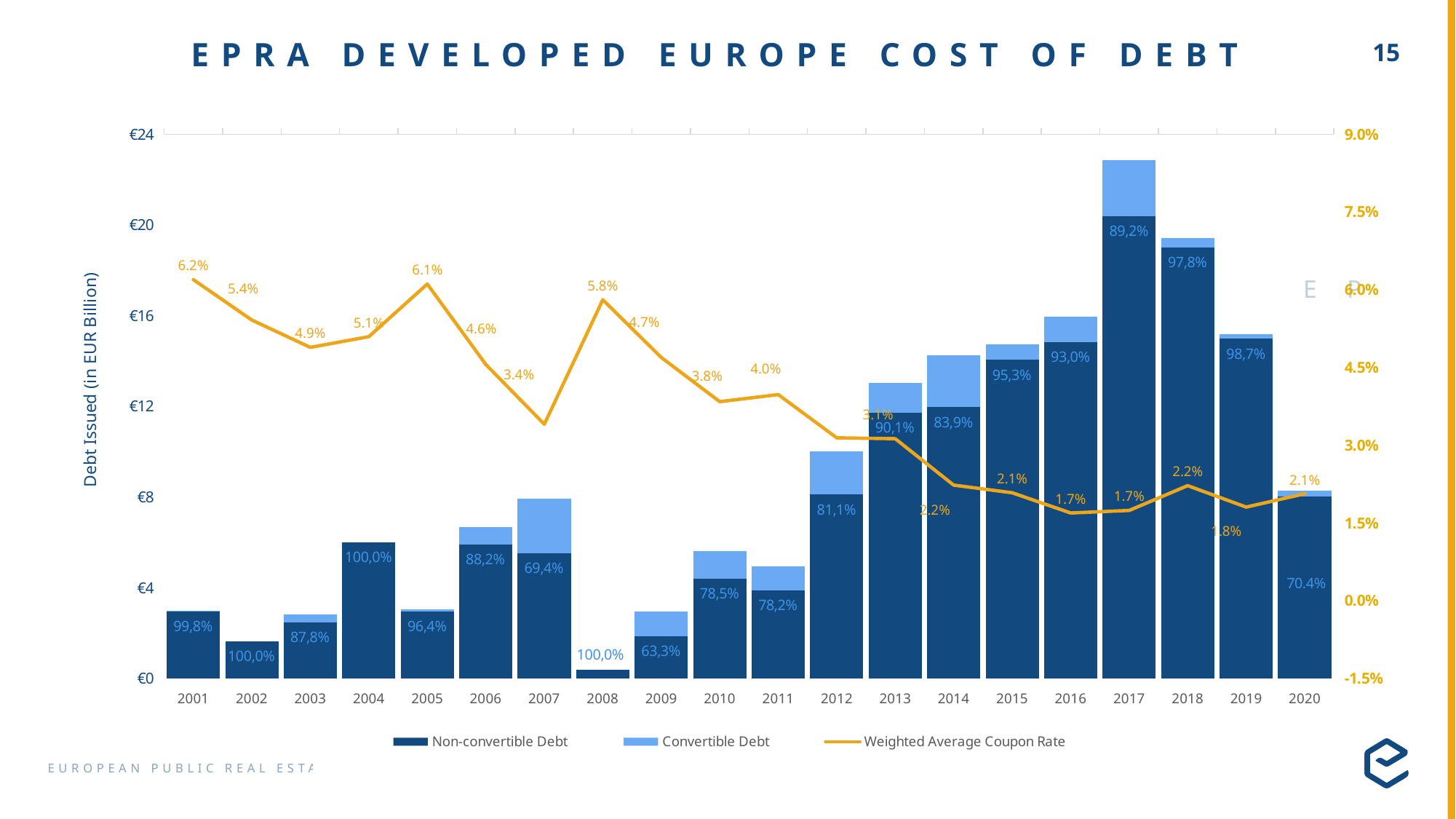
What is the difference in percentage points between the Weighted Average Coupon Rate in 2001 and in 2020? 4.1 percentage points Is the total debt issued in 2008 greater or less than €4 billion? less Is the total debt issued in 2017 greater or less than €20 billion? greater In which year is the Weighted Average Coupon Rate highest? 2001 How many series does the legend list? 3 What is the Weighted Average Coupon Rate shown for 2007? 3.4% What percentage label is printed on the 2009 bar? 63,3% What kind of chart is this? Combined stacked bar and line chart How many years are shown on the x axis? 20 What is the Weighted Average Coupon Rate shown for 2001? 6.2% Which year has a taller total debt issued bar, 2017 or 2018? 2017 Does the Weighted Average Coupon Rate rise or fall from 2001 to 2003? Fall